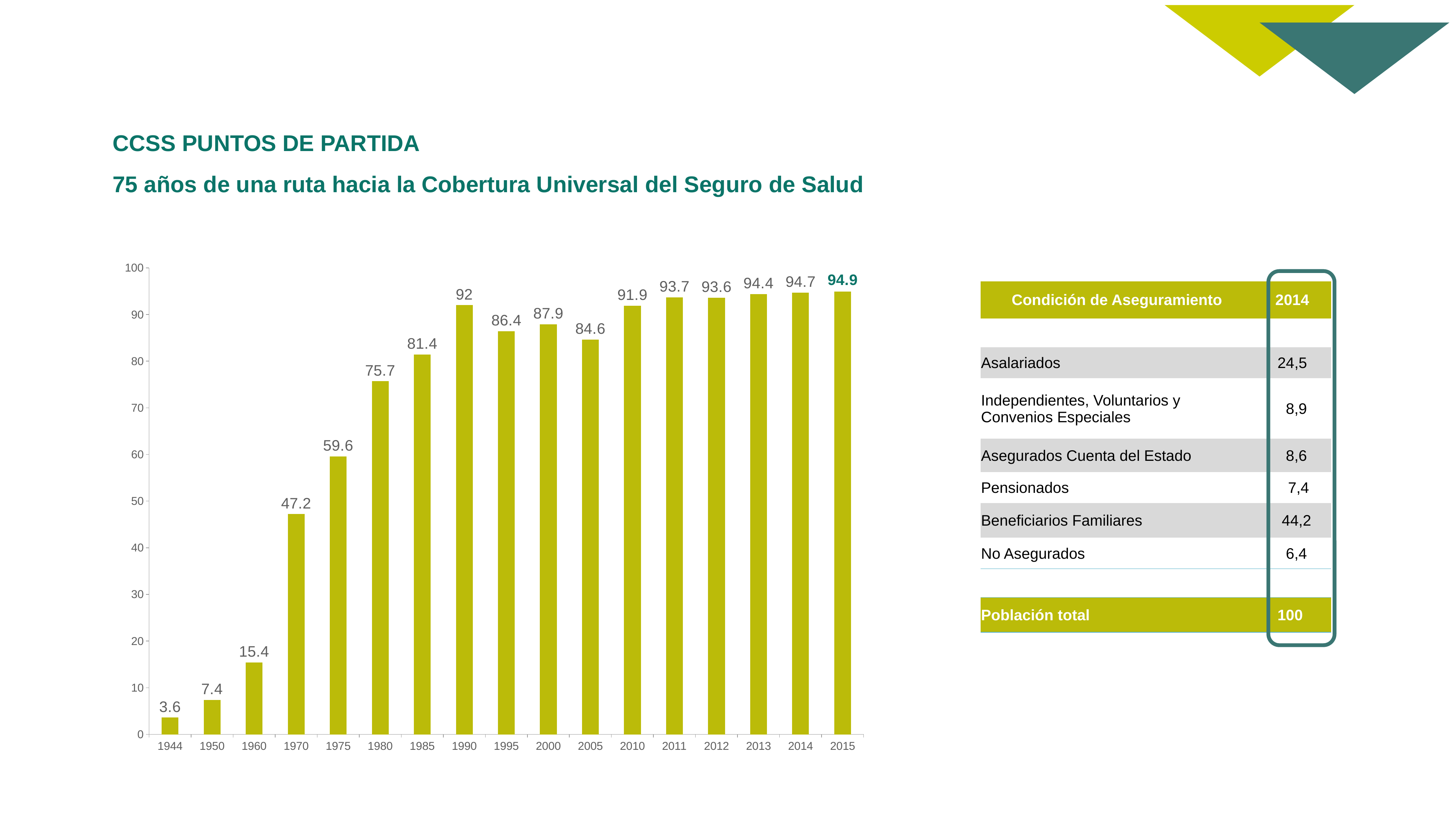
What is the value for 1944 in the bar chart? 3.6 What is the value for 1990 in the bar chart? 92 Which year has the highest value in the bar chart? 2015 How many years are shown on the x axis of the bar chart? 17 Which year has the lowest value in the bar chart? 1944 Do the values in the bar chart generally rise or fall from 1944 to 2015? rise What is the difference between the values for 1970 and 1960 in the bar chart? 31.8 What kind of chart is shown on the slide? bar chart Is the value for 1980 greater or less than 70? greater What is the value for 2015 in the bar chart? 94.9 Which is larger in the bar chart, the value for 1995 or the value for 2005? 1995 What is the difference between the values for 2015 and 2014 in the bar chart? 0.2